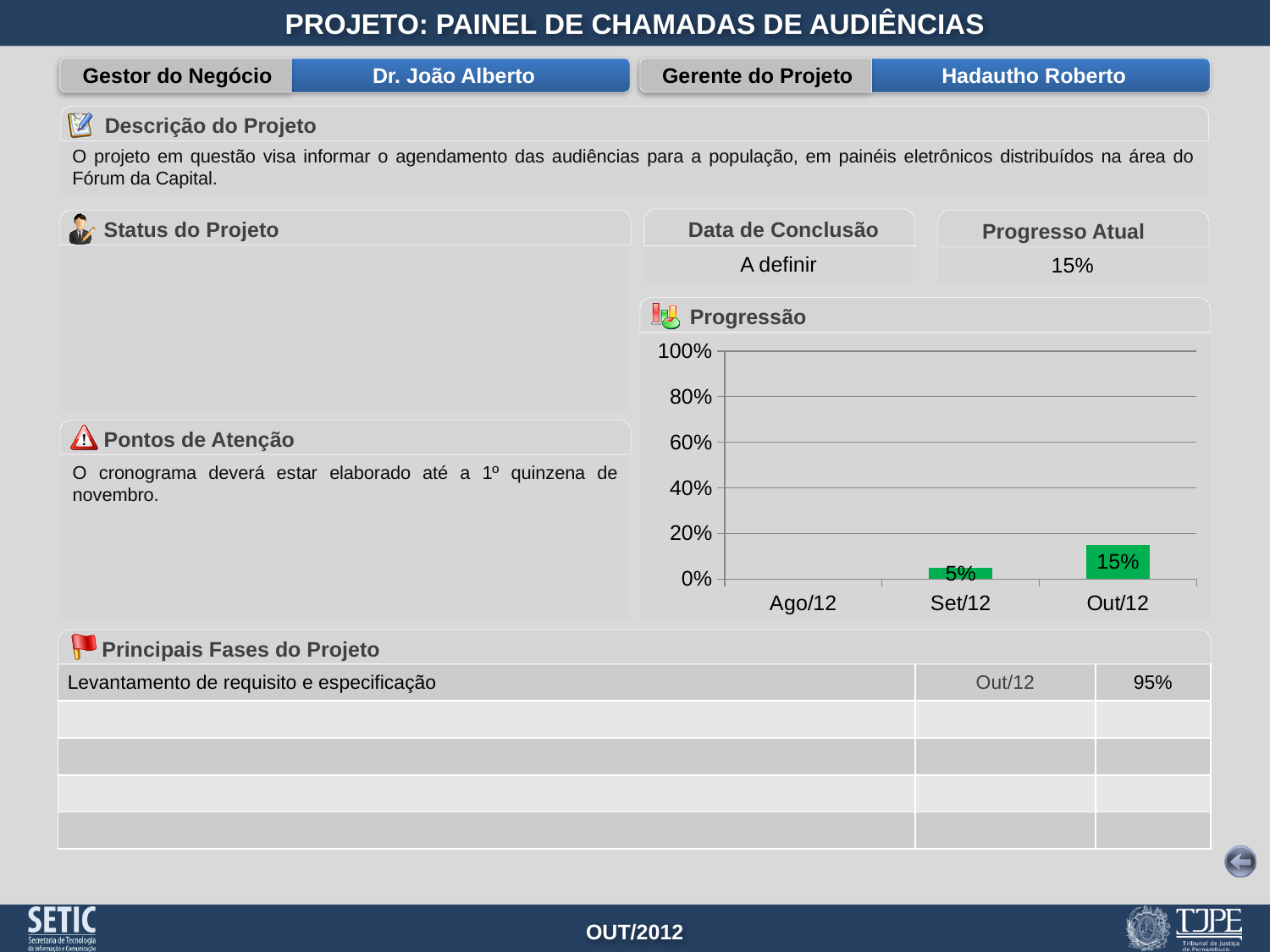
What colour are the bars in the Progressão chart? green In the Progressão chart, what is the value for Set/12? 5% In the Progressão chart, which month has the highest value? Out/12 In the Progressão chart, which is larger: the value for Set/12 or the value for Out/12? Out/12 In the Progressão chart, what is the difference between the values for Out/12 and Set/12? 10% In the Progressão chart, is the value for Out/12 greater or less than 20%? less What type of chart is shown under the heading "Progressão"? bar chart In the Progressão chart, do the values rise or fall from Set/12 to Out/12? rise In the Progressão chart, what is the value for Out/12? 15% How many months are shown on the x axis of the Progressão chart? 3 What is the highest value shown on the y axis of the Progressão chart? 100%